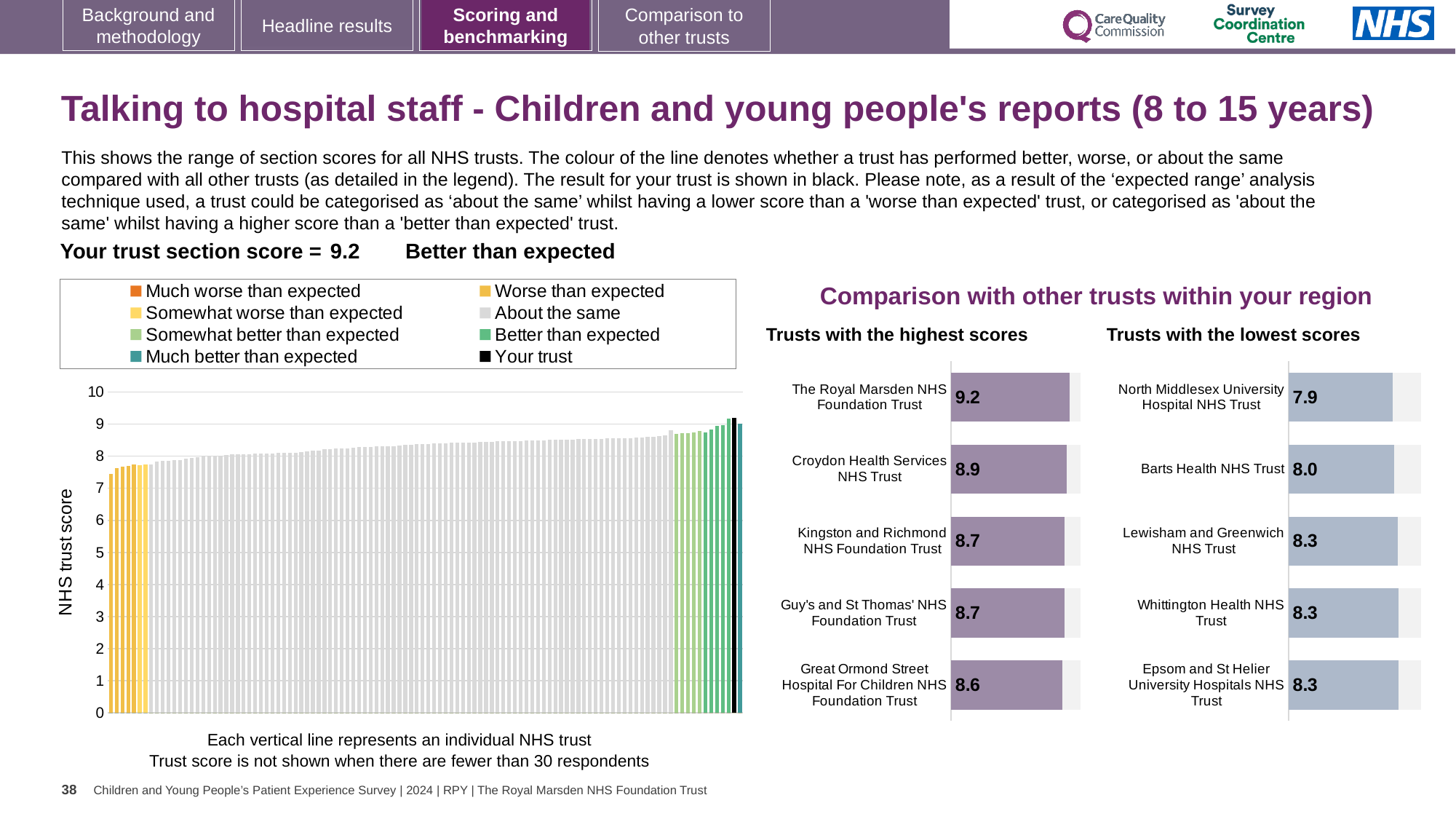
In the large chart on the left, what is the label on the vertical axis? NHS trust score In the 'Trusts with the lowest scores' chart, which has the larger score: Barts Health NHS Trust or North Middlesex University Hospital NHS Trust? Barts Health NHS Trust In the 'Trusts with the highest scores' chart, which trust has the lowest score? Great Ormond Street Hospital For Children NHS Foundation Trust In the 'Trusts with the lowest scores' chart, which trust has the lowest score? North Middlesex University Hospital NHS Trust How many trusts are shown in the 'Trusts with the highest scores' chart? 5 In the 'Trusts with the lowest scores' chart, what is the score for Barts Health NHS Trust? 8.0 In the 'Trusts with the highest scores' chart, what is the score for The Royal Marsden NHS Foundation Trust? 9.2 In the large chart on the left, is the value of the leftmost bar greater or less than 8? less How many entries does the legend above the large chart on the left list? 8 What kind of chart is the large chart on the left showing NHS trust scores? Bar chart In the large chart on the left, do the bar heights rise or fall from left to right? Rise In the 'Trusts with the highest scores' chart, what is the difference between the scores of The Royal Marsden NHS Foundation Trust and Great Ormond Street Hospital For Children NHS Foundation Trust? 0.6